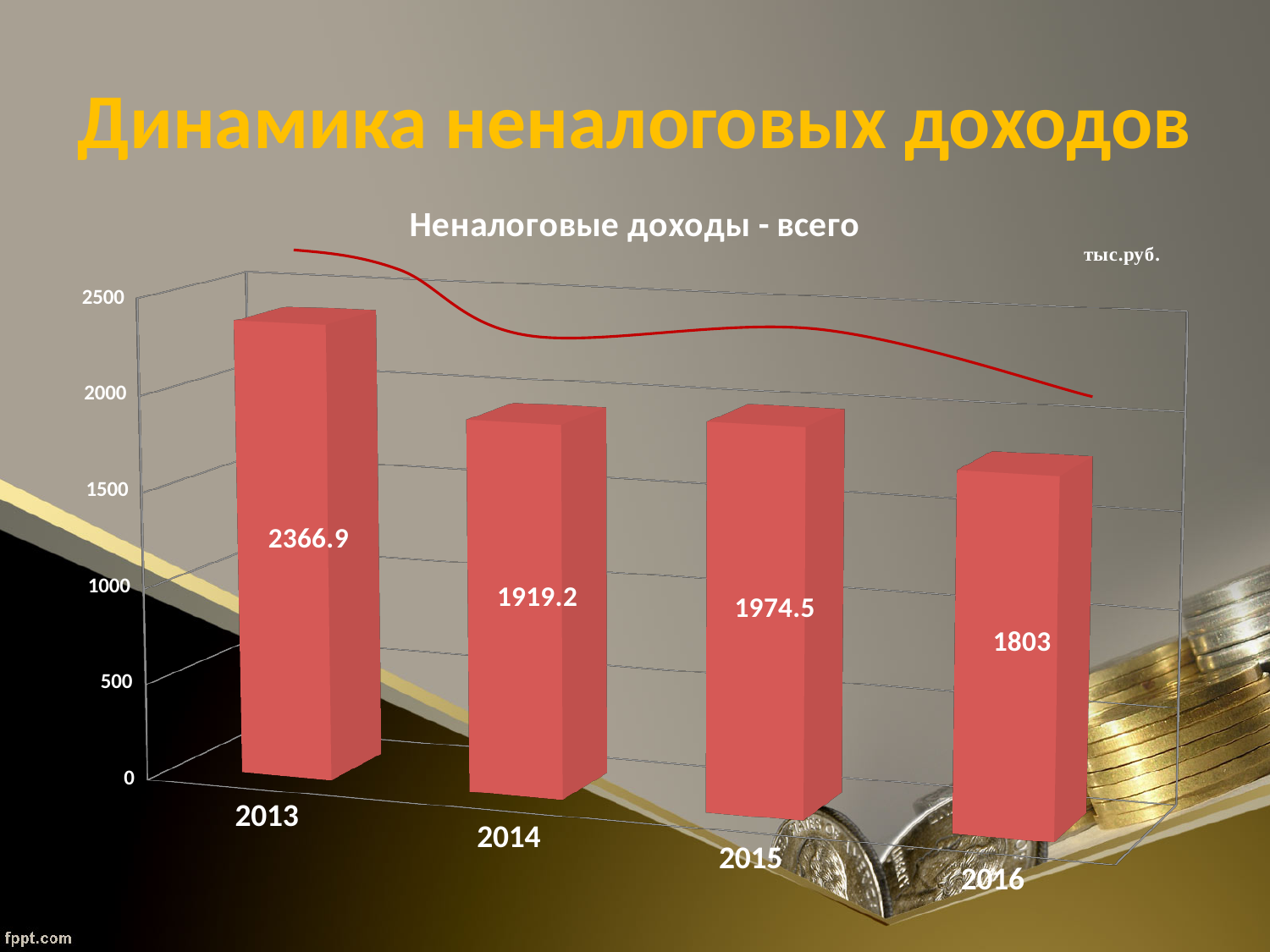
Which year has the highest value? 2013 What kind of chart is this? bar chart What is the value for 2013? 2366.9 What is the value for 2014? 1919.2 How many years are shown on the x axis? 4 Is the value for 2016 greater or less than 2000? less What is the value for 2016? 1803 What is the difference between the values for 2013 and 2016? 563.9 What is the title of the chart? Неналоговые доходы - всего Which year has the lowest value? 2016 What is the value for 2015? 1974.5 Which is larger, the value for 2014 or the value for 2015? 2015